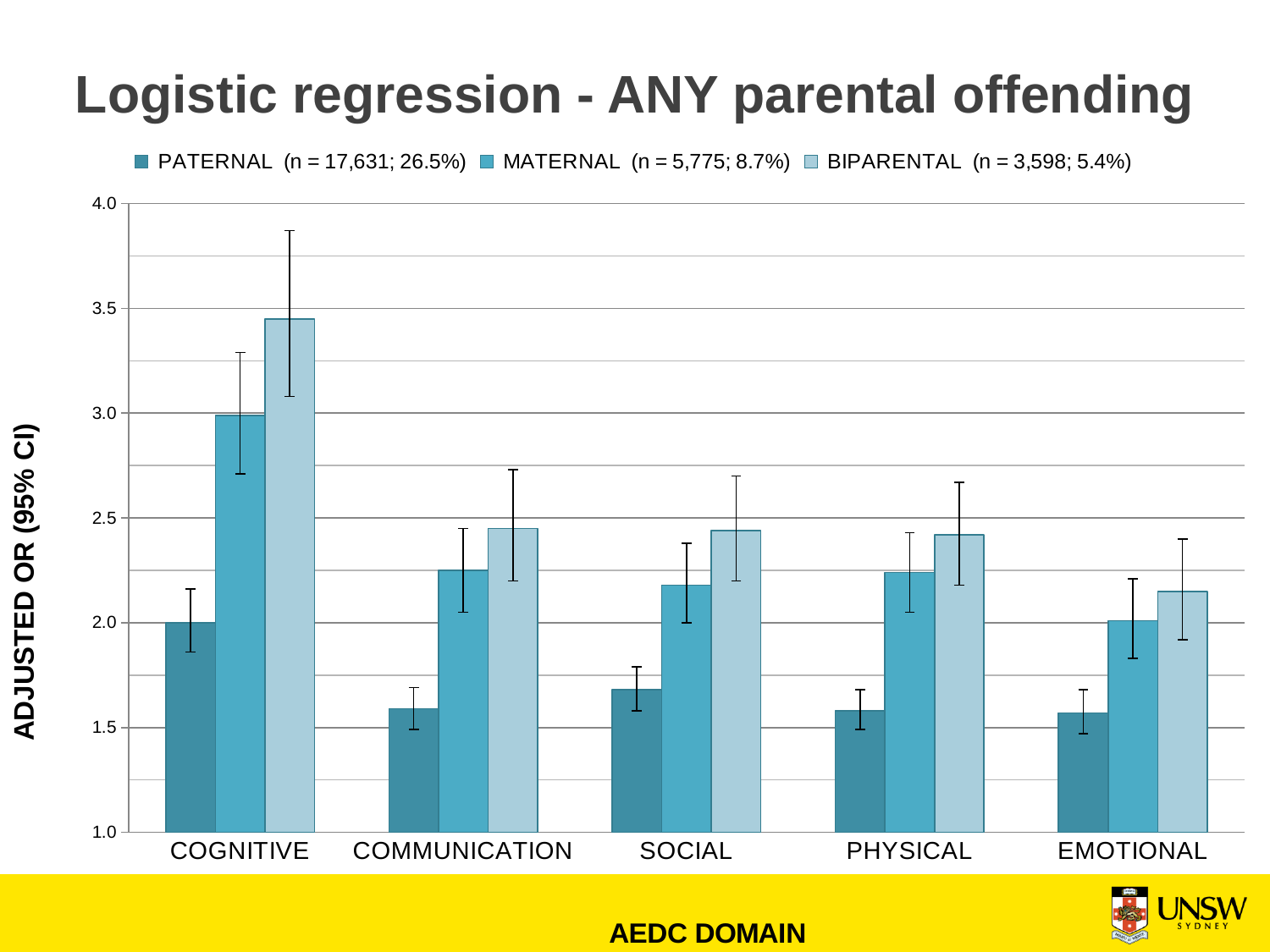
What is the label of the y axis? ADJUSTED OR (95% CI) Which category has the highest BIPARENTAL adjusted OR? COGNITIVE How many AEDC domain categories are shown on the x axis? 5 Is the PATERNAL value for COMMUNICATION greater or less than 2.0? less What kind of chart is shown on the slide? bar chart How many series does the legend list? 3 Does the PATERNAL series rise or fall from COGNITIVE to COMMUNICATION? fall Is the BIPARENTAL value for COGNITIVE greater or less than 3.0? greater Which category has the highest PATERNAL adjusted OR? COGNITIVE Is the MATERNAL value for COGNITIVE greater or less than 2.5? greater For the SOCIAL domain, which is larger: the MATERNAL value or the PATERNAL value? MATERNAL